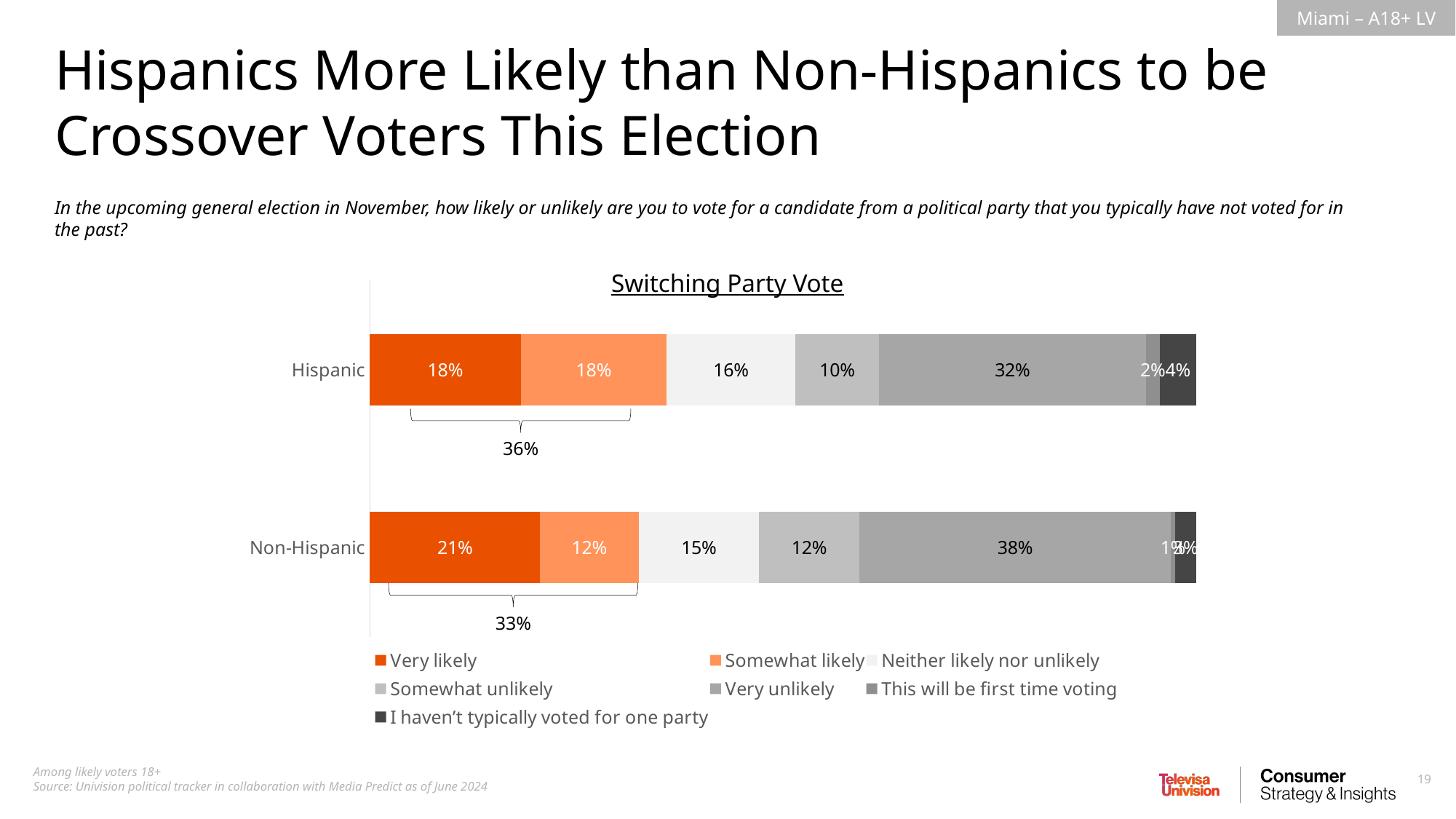
How many series does the legend of the "Switching Party Vote" chart list? 7 How many categories (bars) are shown in the "Switching Party Vote" chart? 2 What is the "Very unlikely" value for Hispanic? 32% What kind of chart is shown under the title "Switching Party Vote"? Stacked bar chart What is the combined "Very likely" plus "Somewhat likely" share shown by the bracket for Non-Hispanic? 33% What is the "Somewhat likely" value for Non-Hispanic? 12% What is the difference between the "Very unlikely" values for Non-Hispanic and Hispanic? 6% What is the "Very likely" value for Hispanic? 18% Which group has the larger "Somewhat likely" value, Hispanic or Non-Hispanic? Hispanic What is the combined "Very likely" plus "Somewhat likely" share shown by the bracket for Hispanic? 36% What is the "Very likely" value for Non-Hispanic? 21% What is the "Neither likely nor unlikely" value for Non-Hispanic? 15%